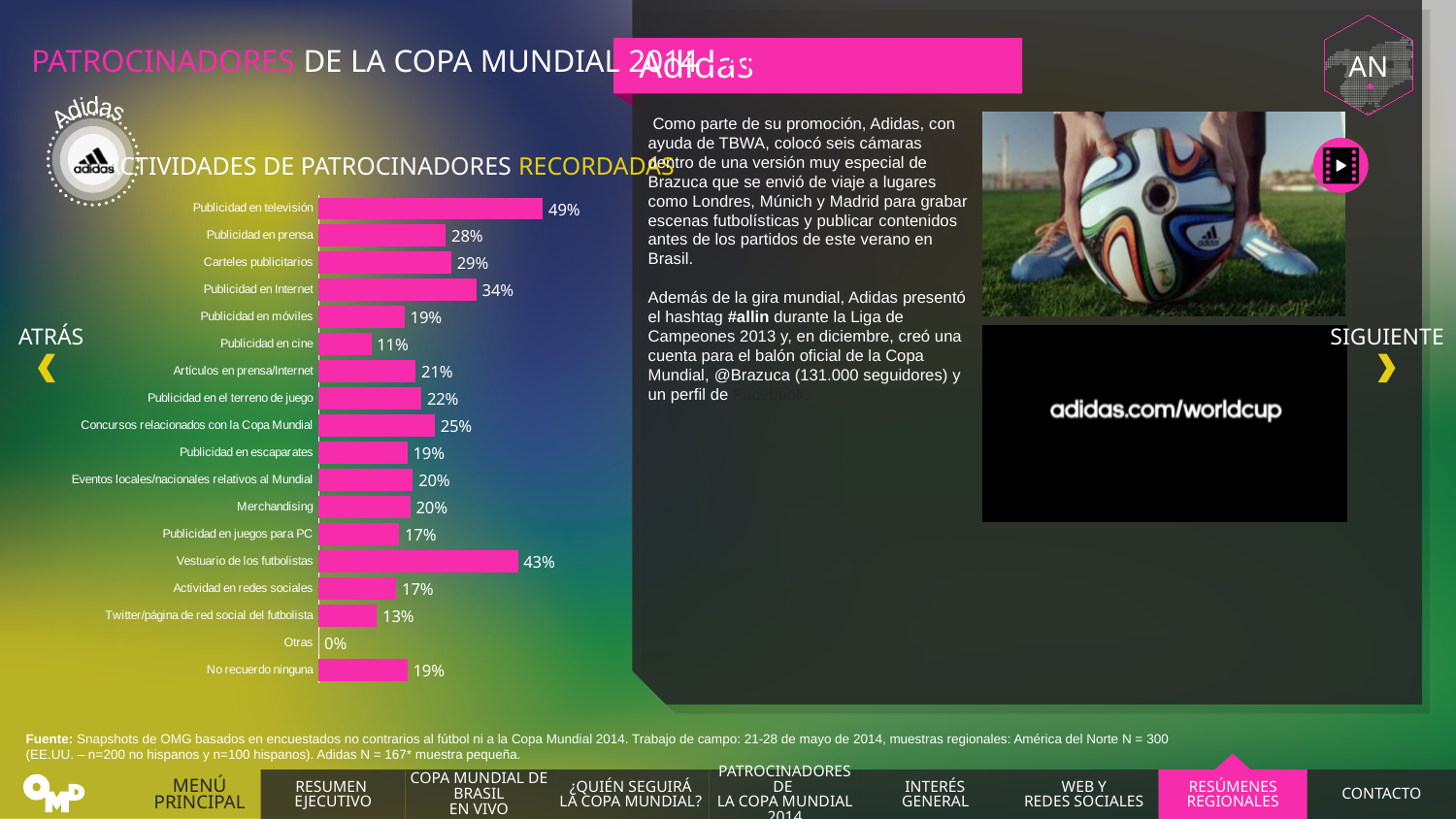
Which category has the lowest value in the chart? Otras What is the difference between the values for Publicidad en Internet and Publicidad en prensa? 6% Which is larger, the value for Concursos relacionados con la Copa Mundial or the value for Publicidad en el terreno de juego? Concursos relacionados con la Copa Mundial Which is larger, the value for Carteles publicitarios or the value for Publicidad en prensa? Carteles publicitarios What value is shown for Publicidad en televisión? 49% What type of chart is shown on the slide? Bar chart How many categories are shown in the chart? 18 What value is shown for Twitter/página de red social del futbolista? 13% What is the difference between the values for Publicidad en televisión and Vestuario de los futbolistas? 6% What value is shown for Vestuario de los futbolistas? 43% Which category has the highest value in the chart? Publicidad en televisión What value is shown for Publicidad en cine? 11%